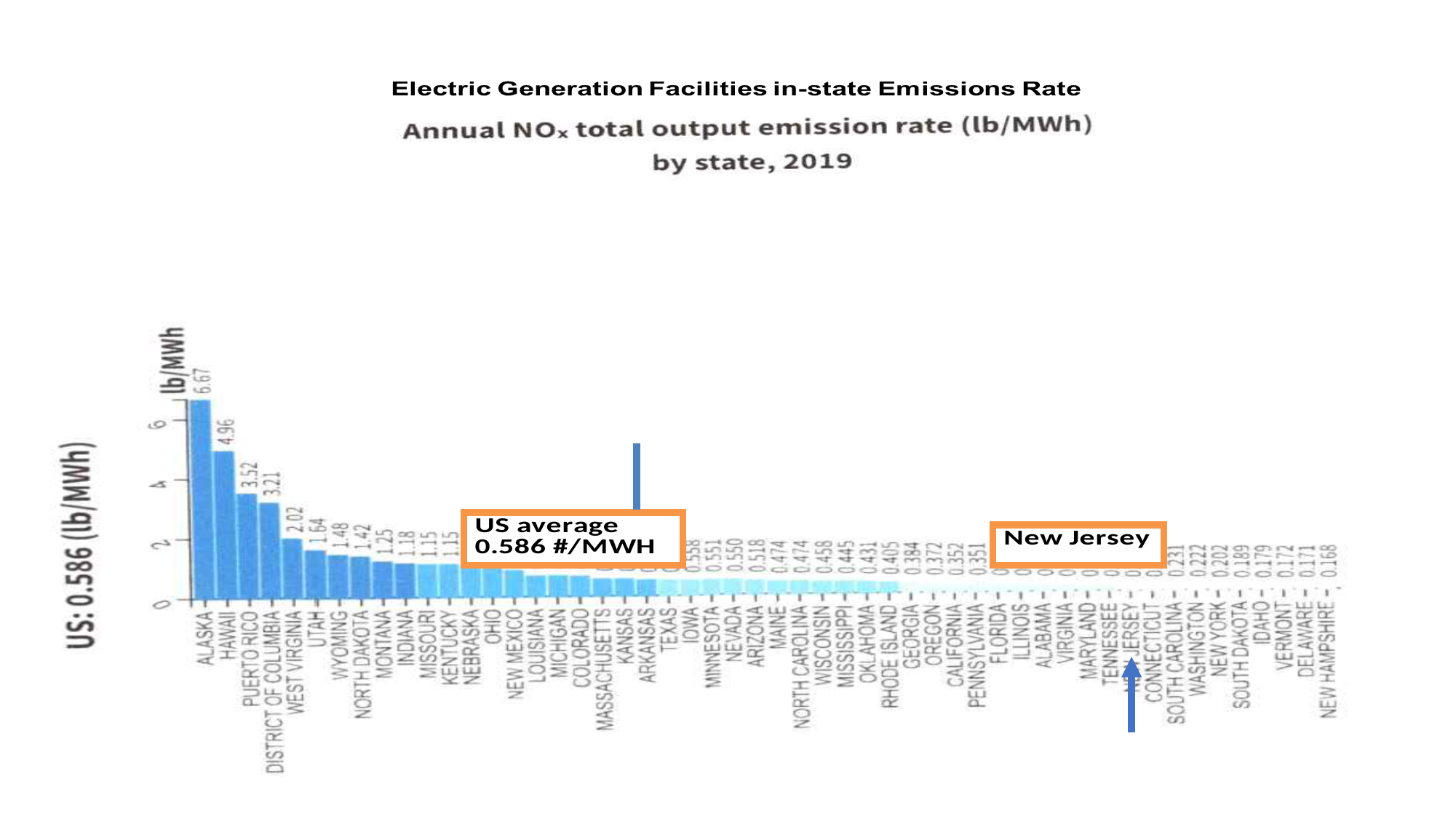
Which state has the lowest annual NOx emission rate? New Hampshire What unit is used on the y axis of the chart? lb/MWh What is the annual NOx emission rate for Montana? 1.25 Is the value for Utah greater or less than 2? less Do the values rise or fall moving from left to right along the x axis? fall What is the US average NOx emission rate shown on the slide? 0.586 #/MWH What is the annual NOx emission rate for Alaska? 6.67 What kind of chart is shown on the slide? bar chart Which has a higher emission rate, Puerto Rico or District of Columbia? Puerto Rico What is the difference between the emission rates of Alaska and Hawaii? 1.71 Which state has the highest annual NOx emission rate? Alaska What is the annual NOx emission rate for Hawaii? 4.96